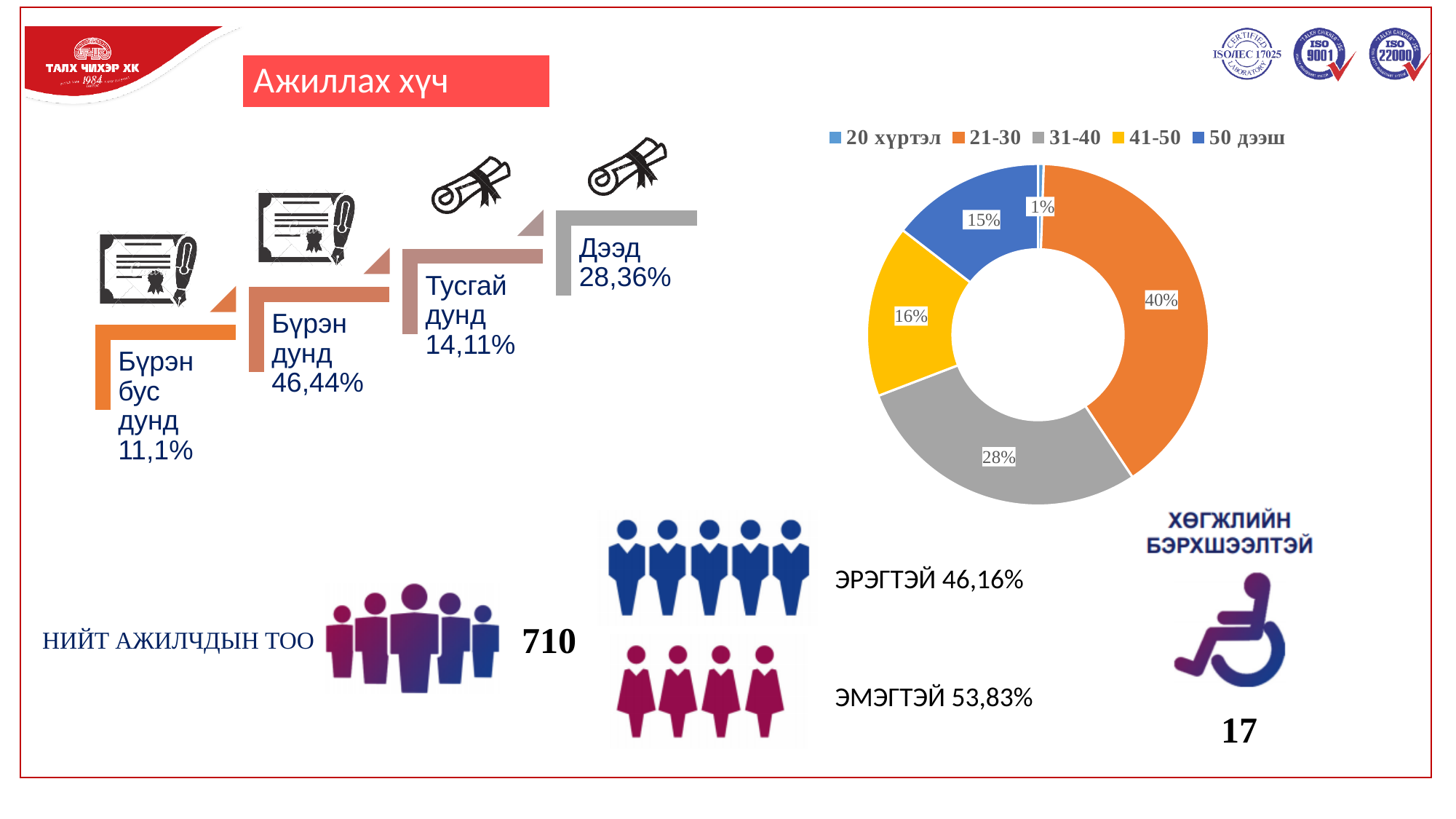
In the age-distribution doughnut chart, how many percentage points larger is the 21-30 share than the 31-40 share? 12% In the age-distribution doughnut chart, which group has the larger share, 41-50 or 50 дээш? 41-50 In the age-distribution doughnut chart, what percentage is shown for the 31-40 group? 28% In the age-distribution doughnut chart, which age group has the smallest share? 20 хүртэл What kind of chart is the age-distribution chart on the right of the slide? doughnut chart In the age-distribution doughnut chart, what percentage is shown for the 20 хүртэл group? 1% In the age-distribution doughnut chart, what colour is the 21-30 slice? orange In the age-distribution doughnut chart, what percentage is shown for the 50 дээш group? 15% In the age-distribution doughnut chart, what percentage is shown for the 21-30 group? 40% In the age-distribution doughnut chart, what percentage is shown for the 41-50 group? 16% In the age-distribution doughnut chart, which age group has the largest share? 21-30 How many age groups does the legend of the doughnut chart list? 5